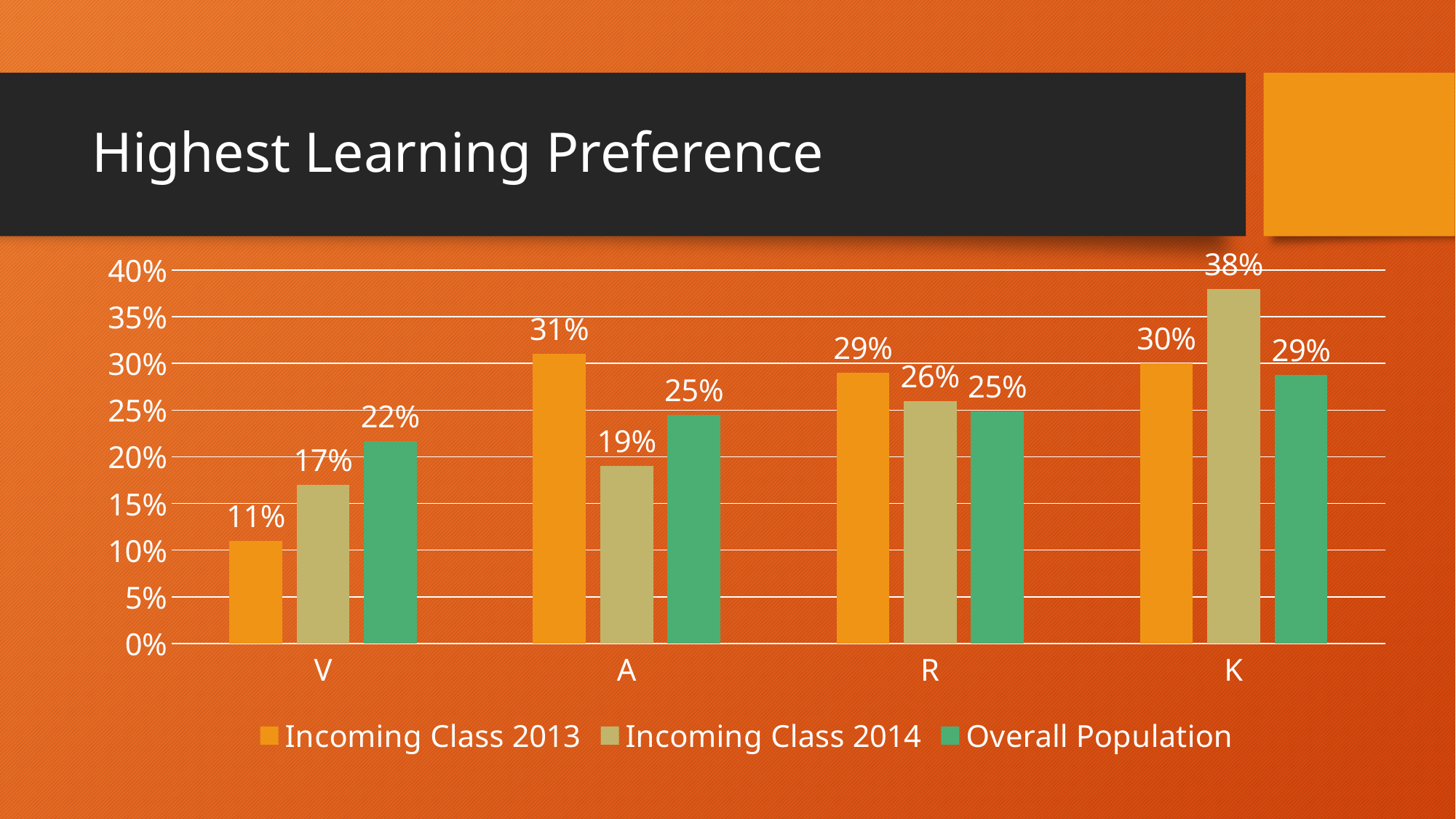
What kind of chart is shown on the slide? Bar chart Which is larger in category R: Incoming Class 2013 or Overall Population? Incoming Class 2013 What is the value for Overall Population in category A? 25% What is the value for Incoming Class 2014 in category K? 38% Which category has the highest value for Incoming Class 2014? K Does the Overall Population series rise or fall from V to K? Rise What is the value for Incoming Class 2013 in category V? 11% How many series does the legend list? 3 Which category has the lowest value for Incoming Class 2013? V How many categories are shown on the x axis? 4 What is the title of the slide? Highest Learning Preference What is the difference between Incoming Class 2013 and Incoming Class 2014 in category A? 12%